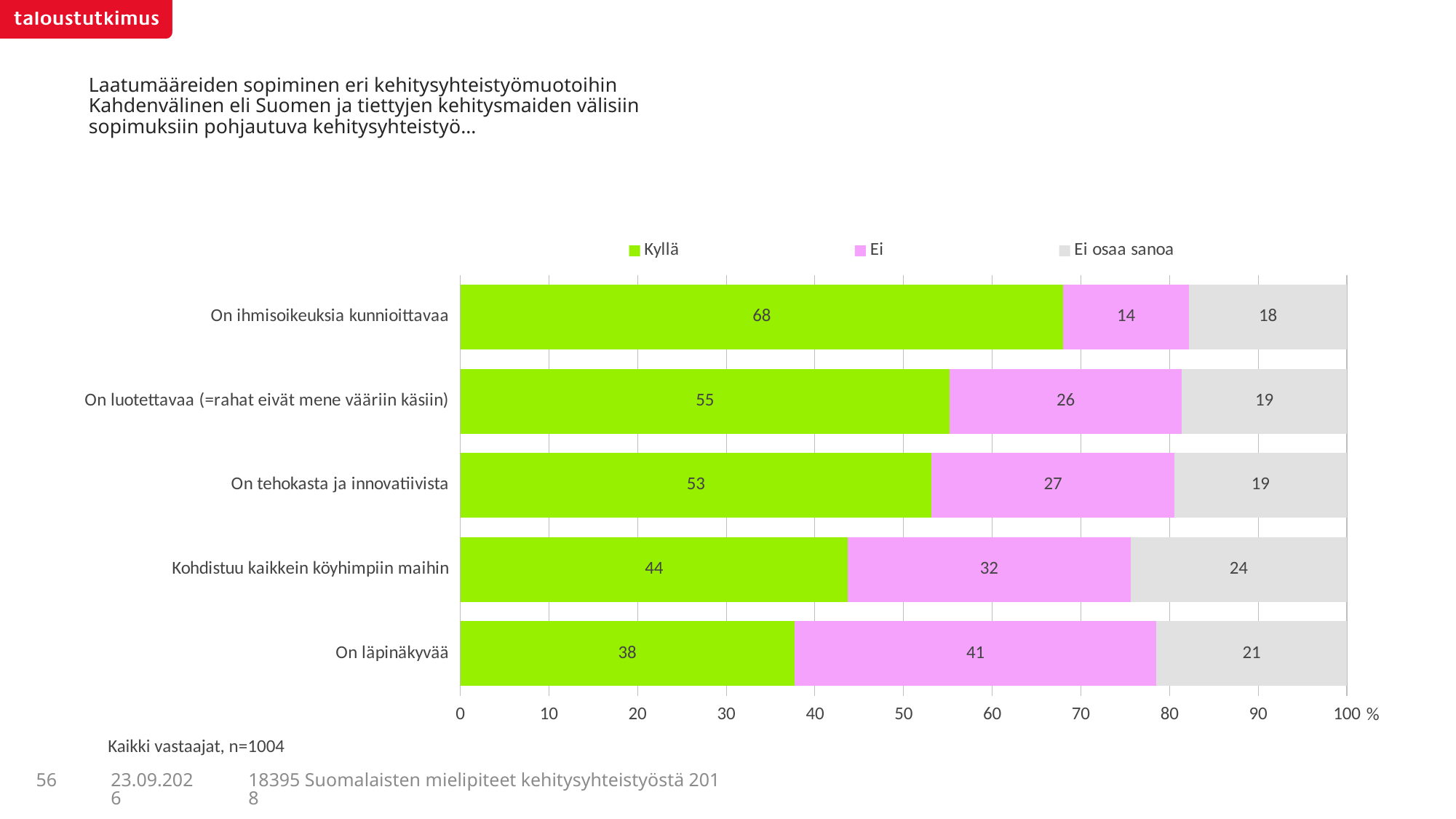
What is the total of the stacked bar for "On tehokasta ja innovatiivista"? 99 How many series does the legend list? 3 How many categories are shown on the chart? 5 What is the Ei osaa sanoa value for "Kohdistuu kaikkein köyhimpiin maihin"? 24 What kind of chart is shown on the slide? Stacked bar chart Which category has the lowest Kyllä value? On läpinäkyvää Which is larger for "On läpinäkyvää": the Kyllä value or the Ei value? Ei What is the Kyllä value for "On ihmisoikeuksia kunnioittavaa"? 68 Which category has the highest Kyllä value? On ihmisoikeuksia kunnioittavaa Which series is shown in green in the legend? Kyllä What is the Ei value for "On läpinäkyvää"? 41 What is the difference between the Kyllä values for "On ihmisoikeuksia kunnioittavaa" and "On luotettavaa (=rahat eivät mene vääriin käsiin)"? 13